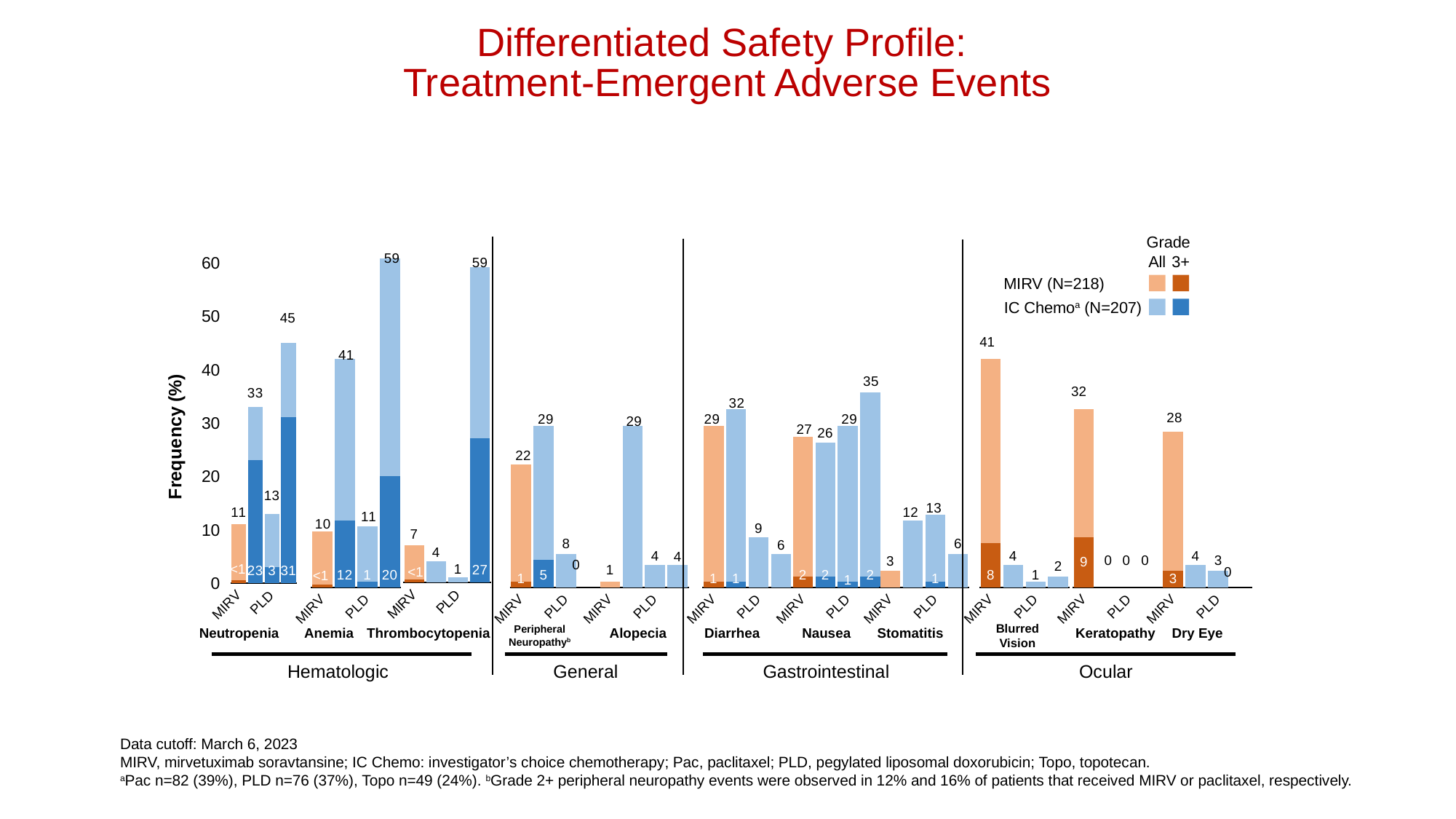
Among the ocular adverse events, which has the highest all-grade frequency for MIRV? Blurred Vision How many treatment groups does the legend list? 2 What is the all-grade frequency of stomatitis for PLD? 13 What is the all-grade frequency of blurred vision for MIRV? 41 What is the all-grade frequency of peripheral neuropathy for MIRV? 22 Is the all-grade frequency of neutropenia for MIRV greater or less than 20? less What is the grade 3+ frequency of keratopathy for MIRV? 9 What is the label of the y axis? Frequency (%) How many adverse event categories are shown along the x axis? 11 For all-grade nausea, which is higher: MIRV or PLD? PLD What is the difference between the all-grade frequencies of blurred vision and dry eye for MIRV? 13 What kind of chart is shown on the slide? bar chart